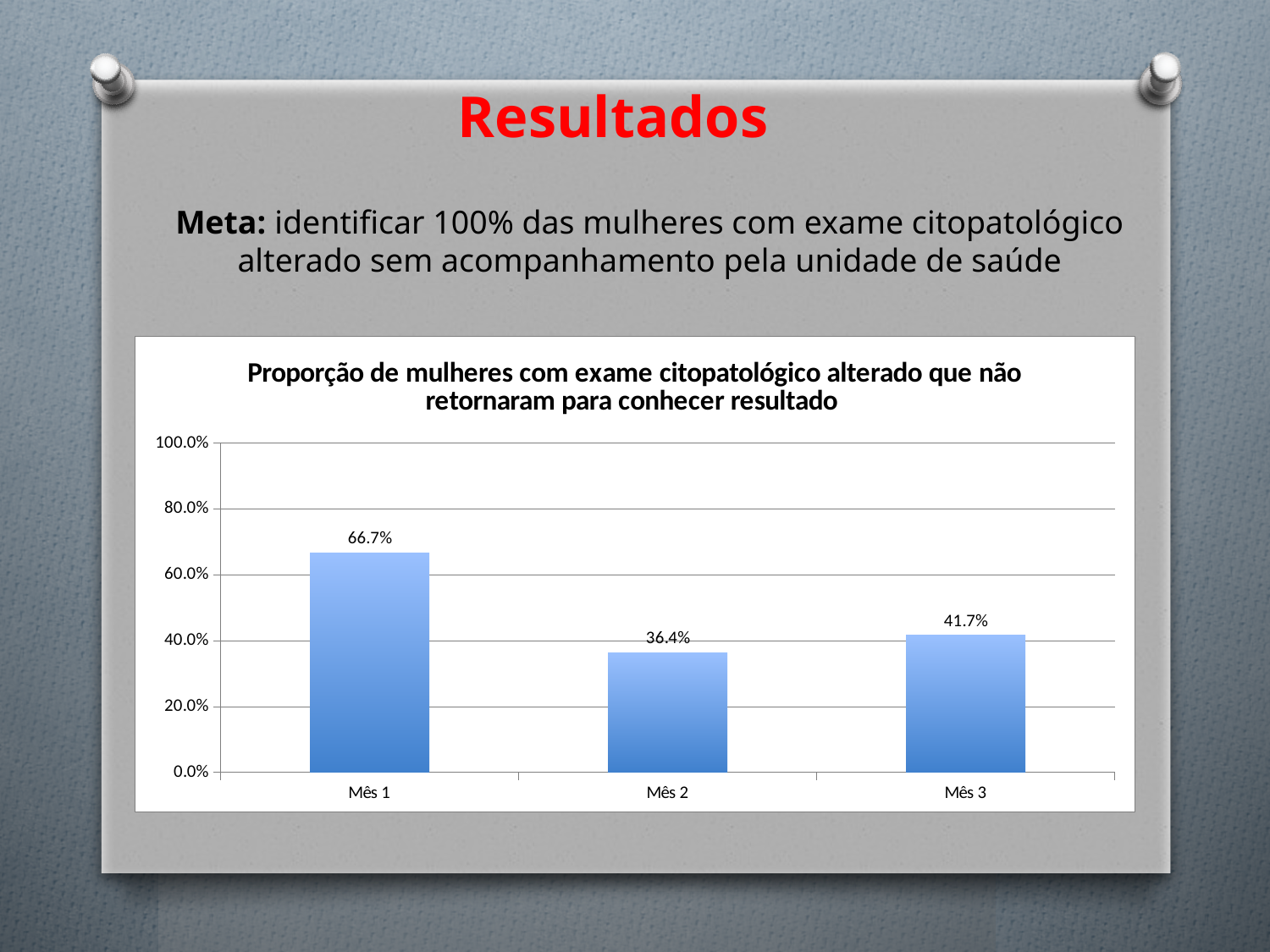
Is the value for Mês 1 greater or less than 60.0%? greater What is the difference between the values for Mês 3 and Mês 2? 5.3% How many months are shown on the x axis? 3 What is the value for Mês 3? 41.7% What is the title of the chart? Proporção de mulheres com exame citopatológico alterado que não retornaram para conhecer resultado Which month has the lowest value? Mês 2 What kind of chart is shown? bar chart Which month has the highest value? Mês 1 What is the difference between the values for Mês 1 and Mês 2? 30.3% Which is larger, the value for Mês 2 or Mês 3? Mês 3 What is the value for Mês 2? 36.4% What is the value for Mês 1? 66.7%